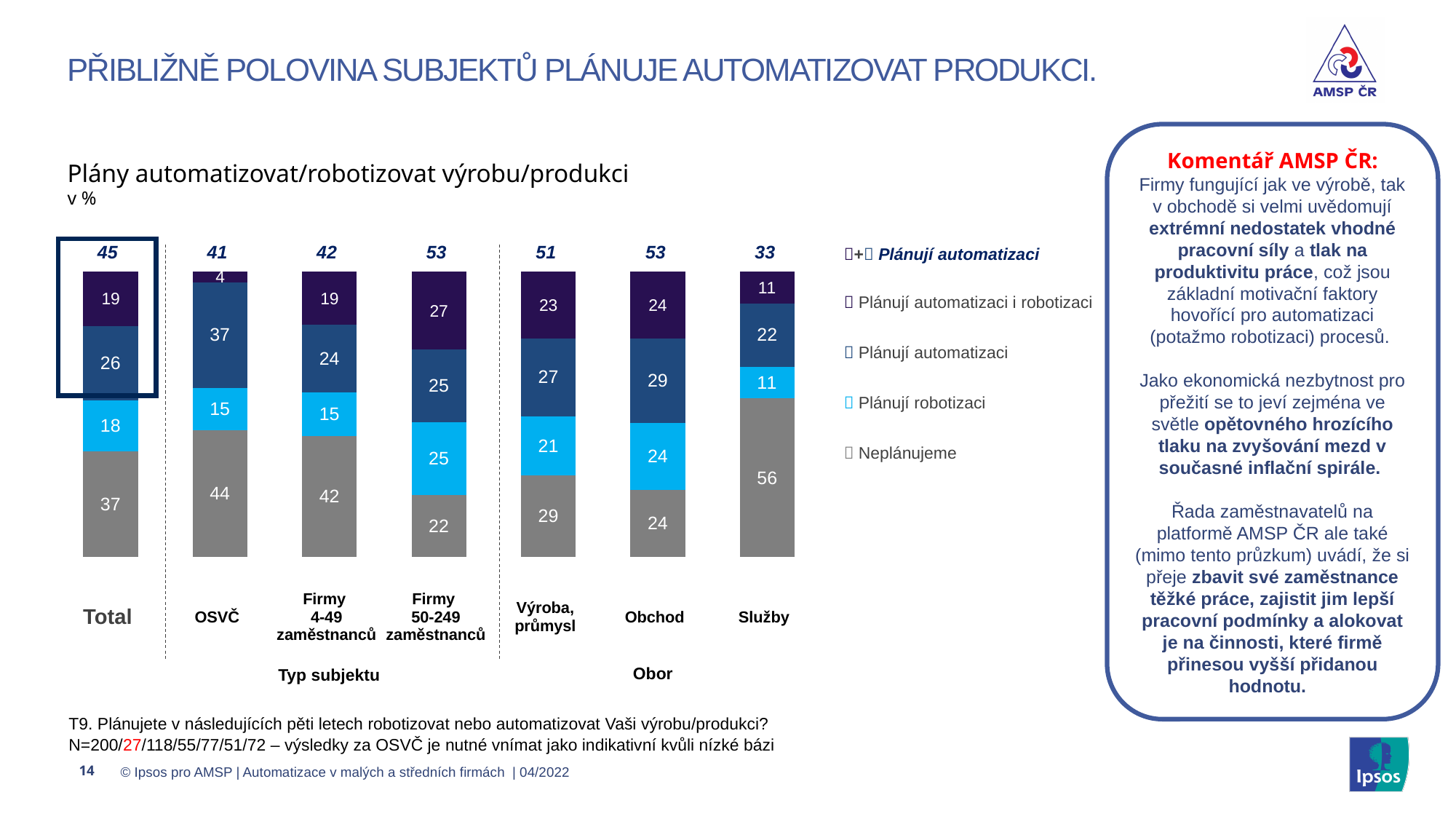
What is the difference between the 'Neplánujeme' values for OSVČ and Firmy 50-249 zaměstnanců? 22 What is the 'Plánují automatizaci i robotizaci' value for Firmy 50-249 zaměstnanců? 27 What is the title of the chart? Plány automatizovat/robotizovat výrobu/produkci What is the combined 'Plánují automatizaci' figure shown above the Total bar? 45 What is the 'Neplánujeme' value for Služby? 56 Which category has the lowest combined 'Plánují automatizaci' figure shown above the bars? Služby How many series does the legend list below the combined 'Plánují automatizaci' entry? 4 How many categories (bars) are shown in the chart? 7 What is the 'Plánují automatizaci' (dark blue) value for Obchod? 29 Which is larger: the 'Plánují robotizaci' value for Firmy 50-249 zaměstnanců or for Výroba, průmysl? Firmy 50-249 zaměstnanců Which category has the highest 'Neplánujeme' value? Služby What type of chart is shown on the slide? stacked bar chart